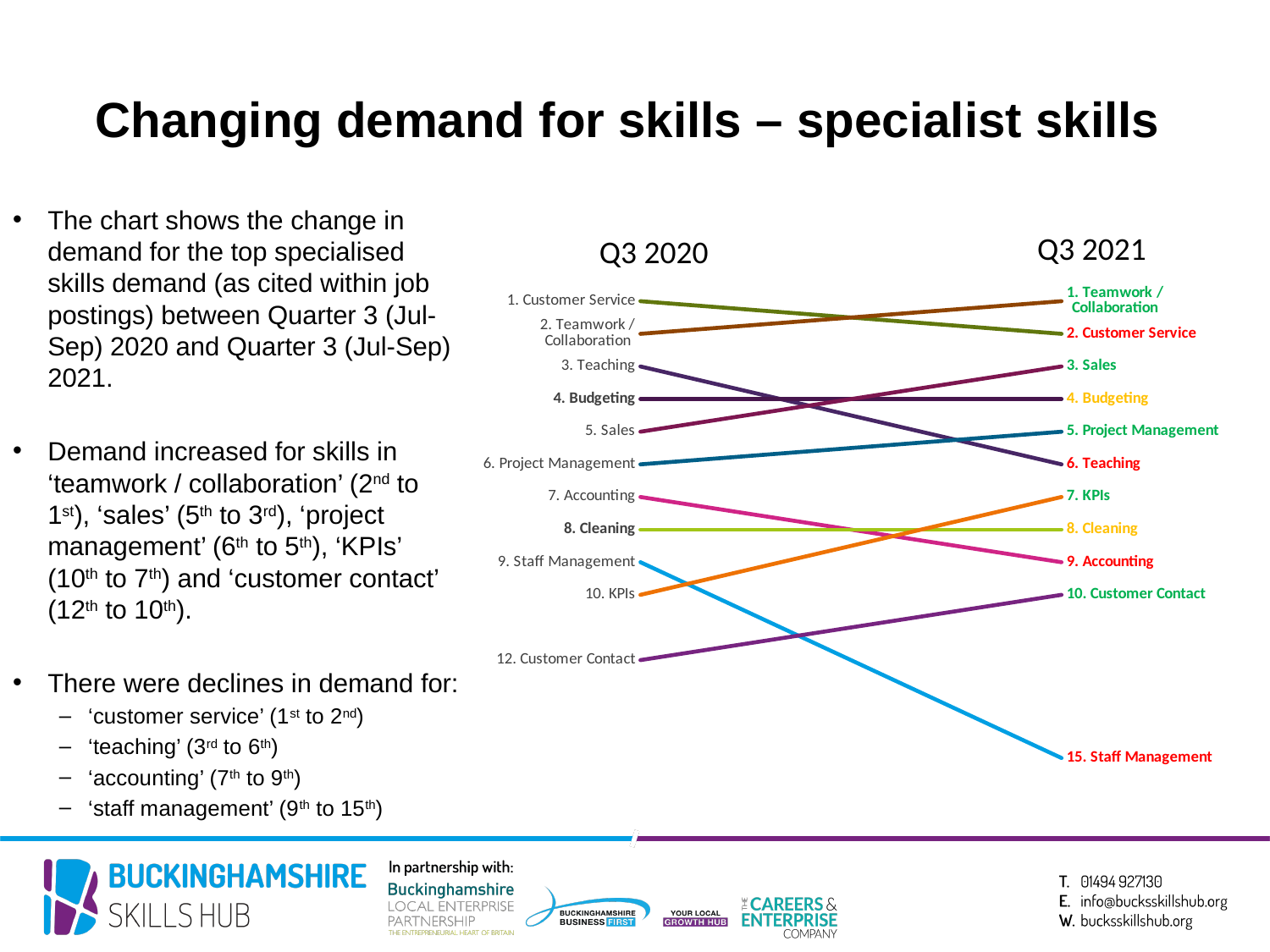
How many skills are plotted in the chart? 11 Which skill was ranked 3rd in Q3 2020? Teaching Did the rank of Sales improve or worsen from Q3 2020 to Q3 2021? improve What rank did Customer Service hold in Q3 2020? 1 Which skill has the lowest (worst) rank in Q3 2021? Staff Management What rank did Customer Contact hold in Q3 2020? 12 What rank did Teamwork / Collaboration hold in Q3 2021? 1 What are the two time periods compared in the chart? Q3 2020 and Q3 2021 What rank did Staff Management hold in Q3 2021? 15 Which skill was ranked 5th in Q3 2021? Project Management By how many places did Staff Management's rank change between Q3 2020 and Q3 2021? 6 Which skill kept the same rank (4th) in both Q3 2020 and Q3 2021? Budgeting